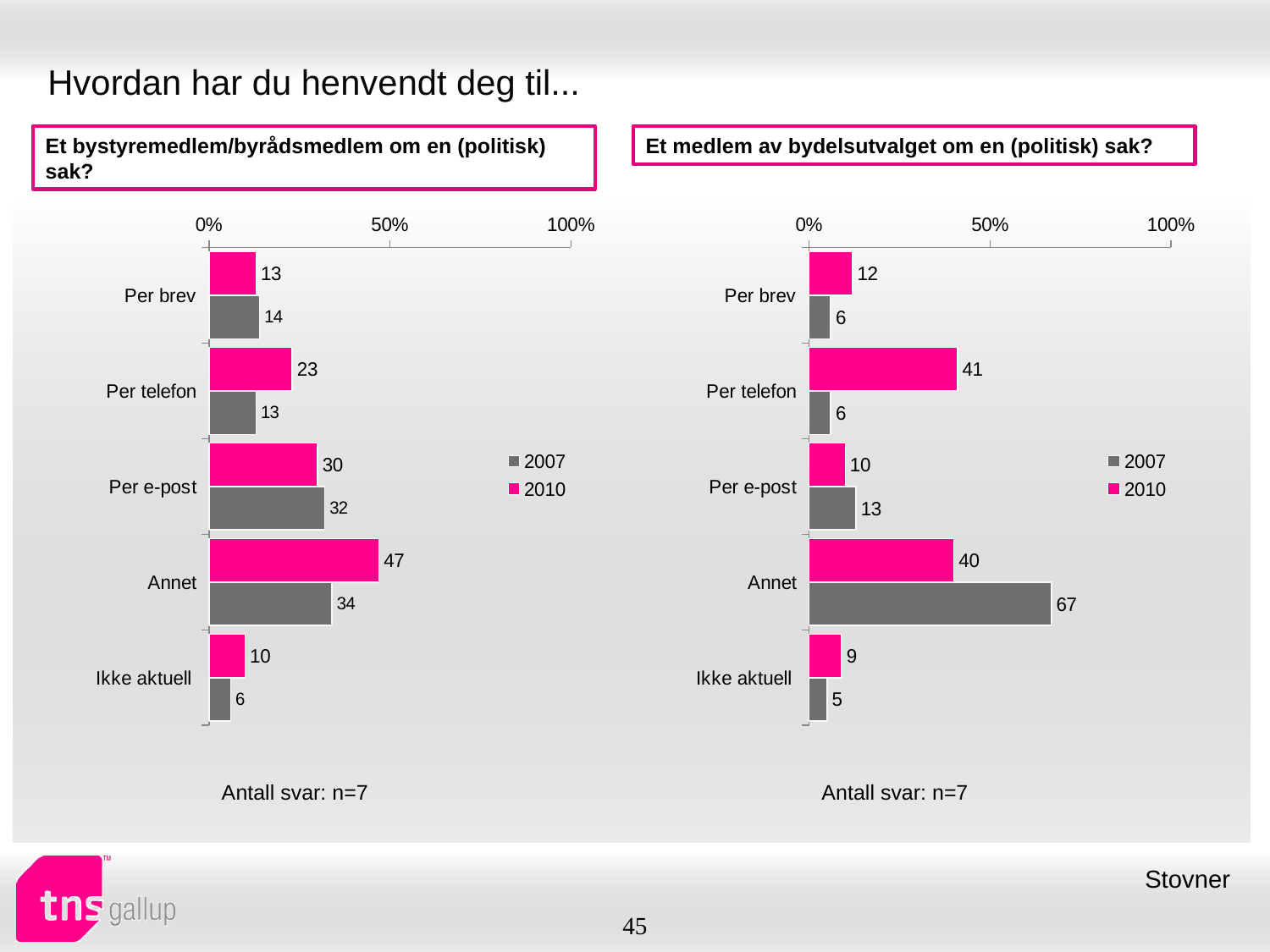
In the left chart (Et bystyremedlem/byrådsmedlem om en (politisk) sak?), which is larger for Per e-post: the 2007 value or the 2010 value? 2007 What type of chart is the left chart (Et bystyremedlem/byrådsmedlem om en (politisk) sak?)? Bar chart In the right chart (Et medlem av bydelsutvalget om en (politisk) sak?), what is the difference between the 2007 and 2010 values for Annet? 27 How many categories are shown in the left chart (Et bystyremedlem/byrådsmedlem om en (politisk) sak?)? 5 In the right chart (Et medlem av bydelsutvalget om en (politisk) sak?), which colour represents the 2010 series? Pink In the left chart (Et bystyremedlem/byrådsmedlem om en (politisk) sak?), what is the value for Annet in 2010? 47 How many series does the legend of the right chart (Et medlem av bydelsutvalget om en (politisk) sak?) list? 2 In the right chart (Et medlem av bydelsutvalget om en (politisk) sak?), what is the value for Per telefon in 2010? 41 In the right chart (Et medlem av bydelsutvalget om en (politisk) sak?), is the 2007 value for Annet greater or less than 50%? greater In the left chart (Et bystyremedlem/byrådsmedlem om en (politisk) sak?), what is the value for Per telefon in 2007? 13 In the right chart (Et medlem av bydelsutvalget om en (politisk) sak?), which category has the highest value for 2007? Annet In the left chart (Et bystyremedlem/byrådsmedlem om en (politisk) sak?), which category has the lowest value for 2007? Ikke aktuell